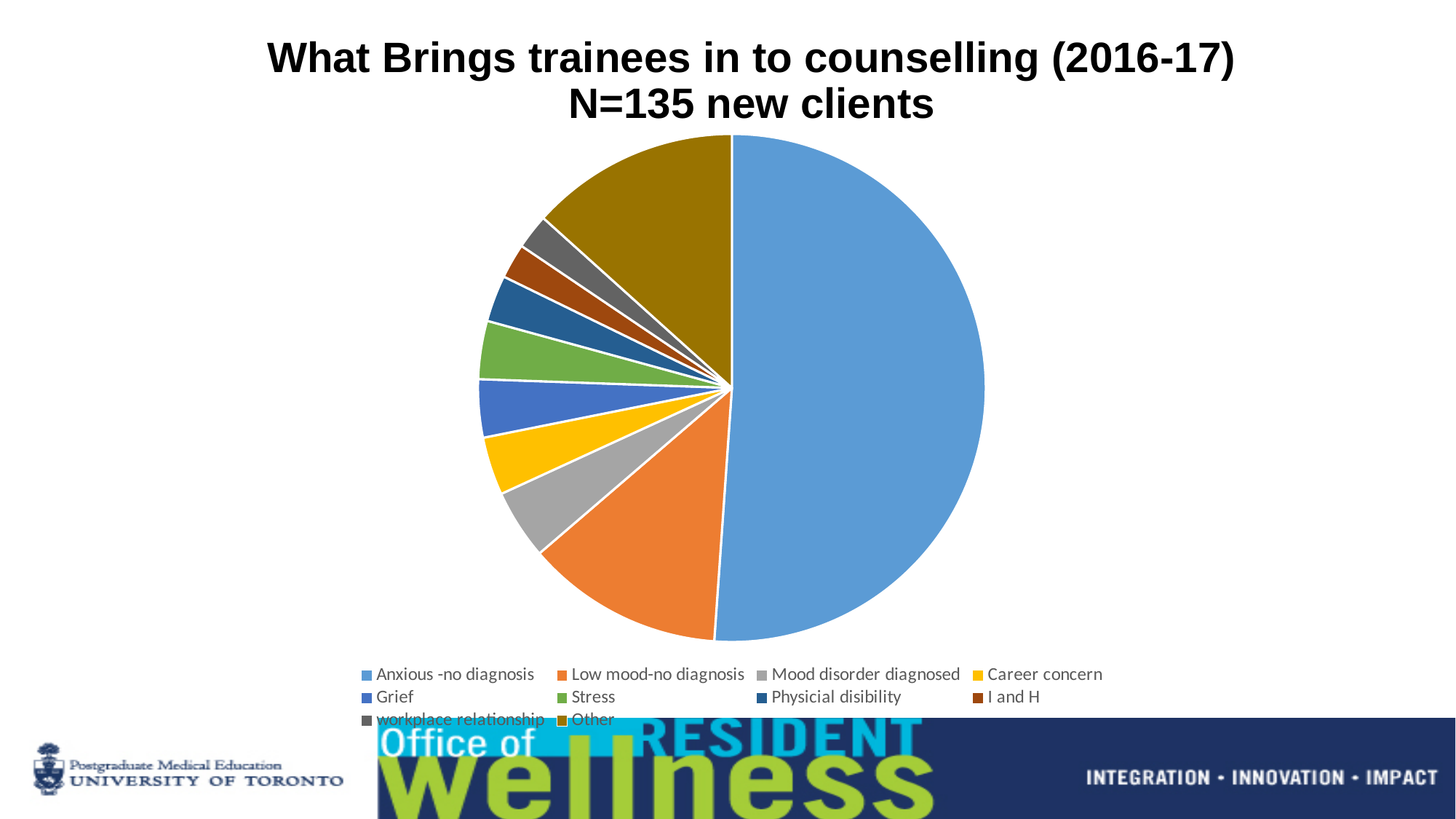
What is the title of the chart? What Brings trainees in to counselling (2016-17) N=135 new clients Which slice is larger, Other or Stress? Other How many new clients does the chart title say the data covers? 135 What kind of chart is shown on the slide? pie chart Which slice is larger, Anxious -no diagnosis or Low mood-no diagnosis? Anxious -no diagnosis Which slice is larger, Career concern or I and H? Career concern Which category has the largest slice of the pie chart? Anxious -no diagnosis How many categories does the pie chart's legend list? 10